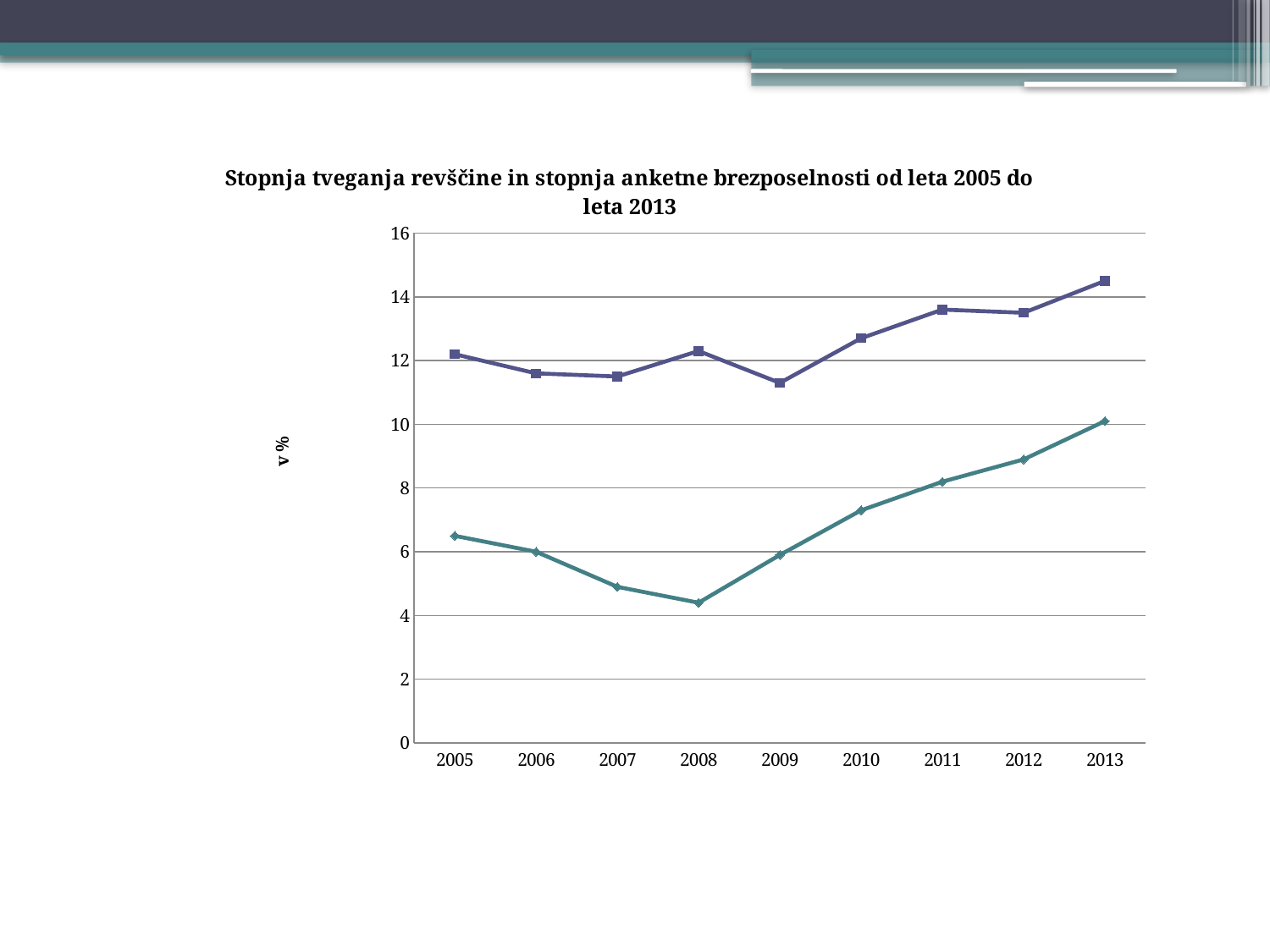
What is the title of the chart? Stopnja tveganja revščine in stopnja anketne brezposelnosti od leta 2005 do leta 2013 Is the value of the teal line with diamond markers in 2008 greater or less than 6? less Is the value of the purple line with square markers in 2013 greater or less than 14? greater Is the value of the teal line with diamond markers in 2012 greater or less than 10? less In which year does the purple line with square markers reach its highest value? 2013 How many years are plotted along the x axis? 9 In which year does the teal line with diamond markers reach its lowest value? 2008 What kind of chart is shown on the slide? line chart Does the teal line with diamond markers rise or fall from 2009 to 2013? rise In which year does the teal line with diamond markers reach its highest value? 2013 What is the label on the vertical axis? v %